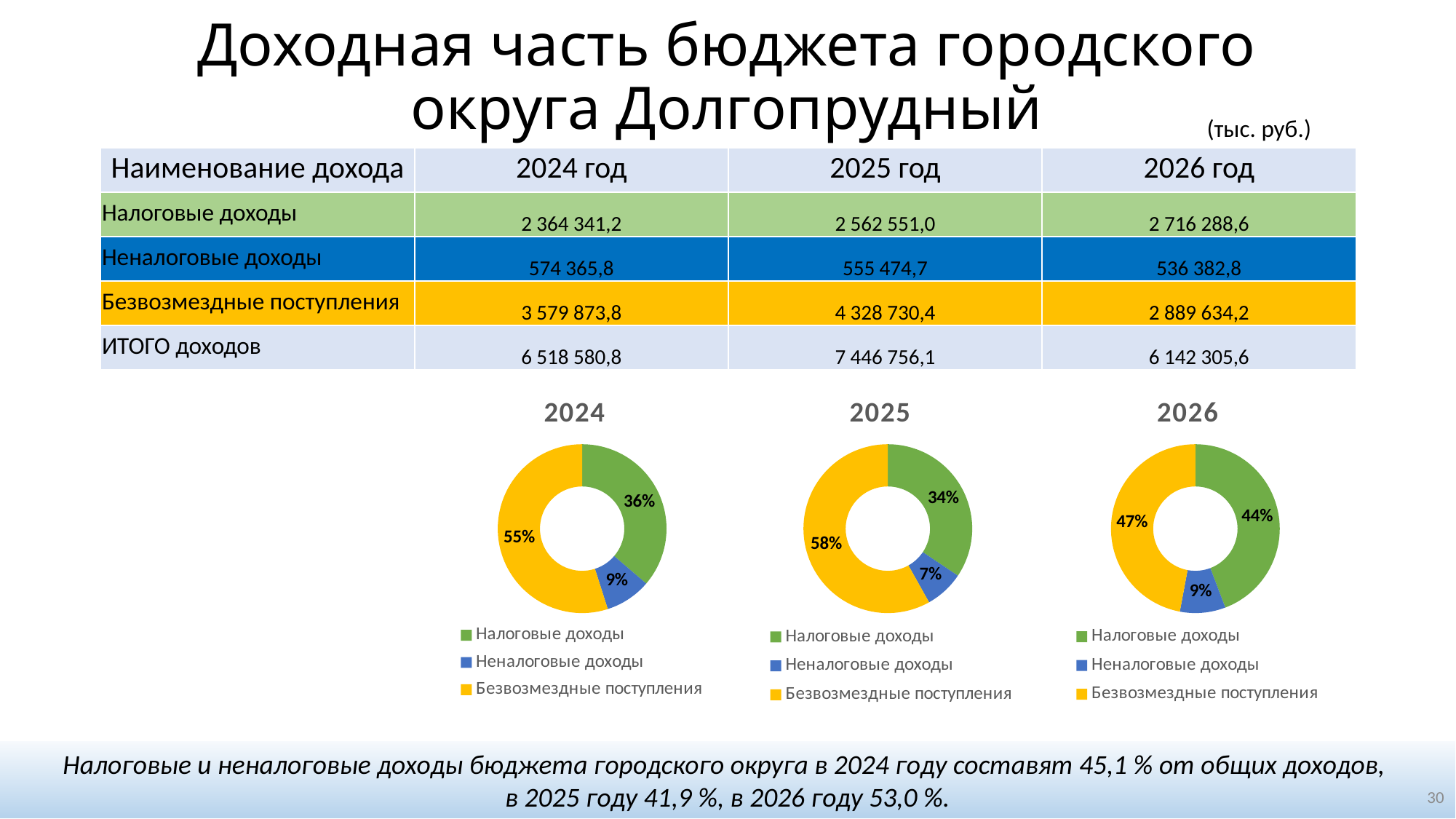
What type of chart is the 2026 chart? Doughnut chart In the 2026 chart, which is larger: the share of Налоговые доходы or the share of Неналоговые доходы? Налоговые доходы How many entries does the legend of the 2024 chart list? 3 How many slices does the 2025 chart have? 3 In the 2024 chart, what share is labelled for Налоговые доходы? 36% In the 2025 chart, which category has the largest slice? Безвозмездные поступления In the 2026 chart, what share is labelled for Безвозмездные поступления? 47% In the 2025 chart, what share is labelled for Неналоговые доходы? 7% In the 2026 chart, which category has the smallest slice? Неналоговые доходы In the 2024 chart, what is the difference between the shares of Безвозмездные поступления and Налоговые доходы? 19% In the 2024 chart, what colour is the slice for Безвозмездные поступления? Yellow What is the title of the leftmost chart on the slide? 2024